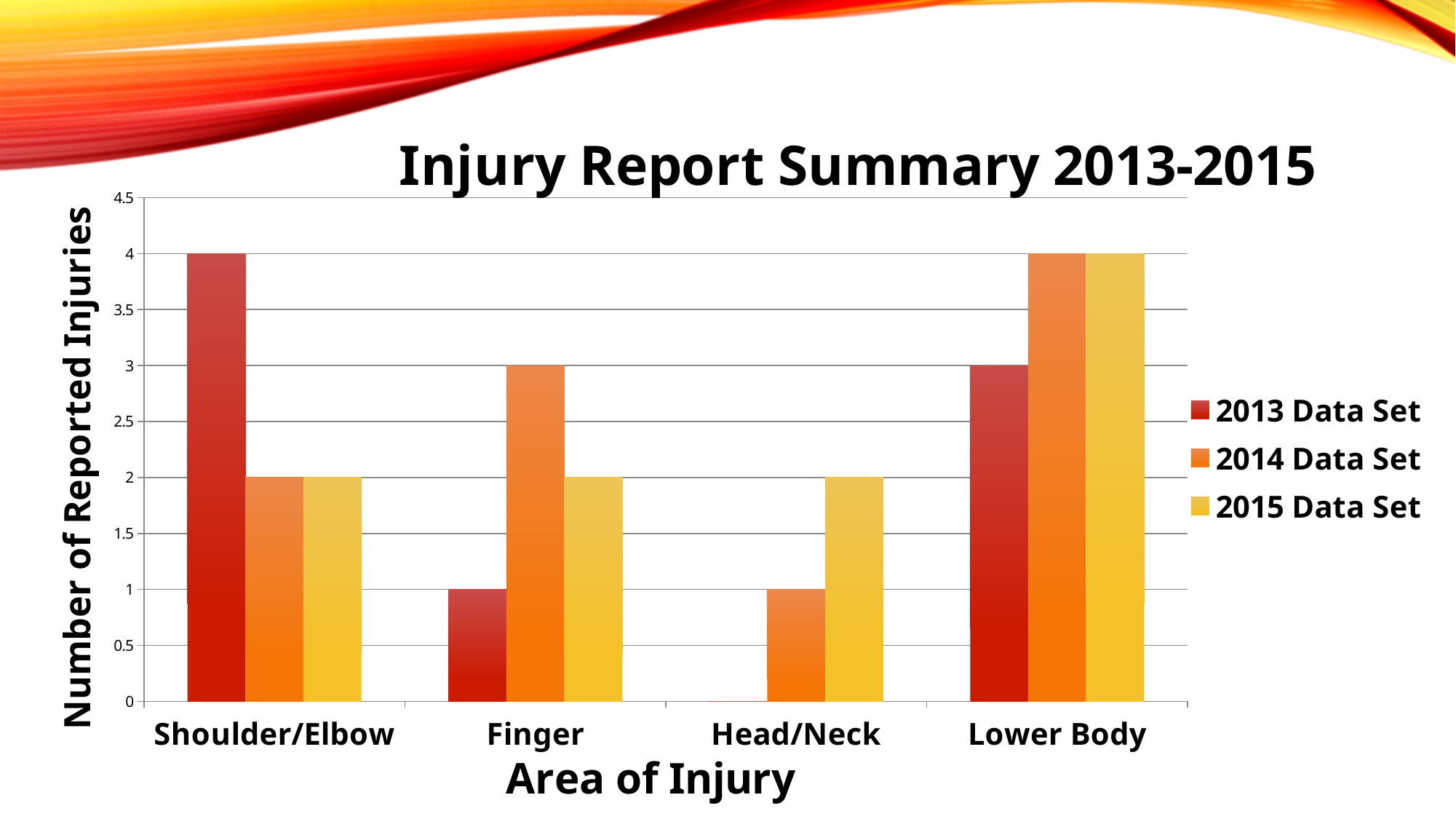
Which area of injury has the lowest value in the 2014 Data Set? Head/Neck Which area of injury has the highest value in the 2013 Data Set? Shoulder/Elbow What is the number of reported Head/Neck injuries in the 2015 Data Set? 2 What is the number of reported Shoulder/Elbow injuries in the 2013 Data Set? 4 Which is larger for Shoulder/Elbow injuries: the 2013 Data Set value or the 2015 Data Set value? 2013 Data Set How many data series does the legend list? 3 What is the number of reported Lower Body injuries in the 2013 Data Set? 3 What is the title of the chart? Injury Report Summary 2013-2015 What is the number of reported Finger injuries in the 2014 Data Set? 3 What is the difference between the 2014 Data Set and the 2013 Data Set values for Finger injuries? 2 How many injury areas are shown on the x axis? 4 What type of chart is shown on the slide? bar chart